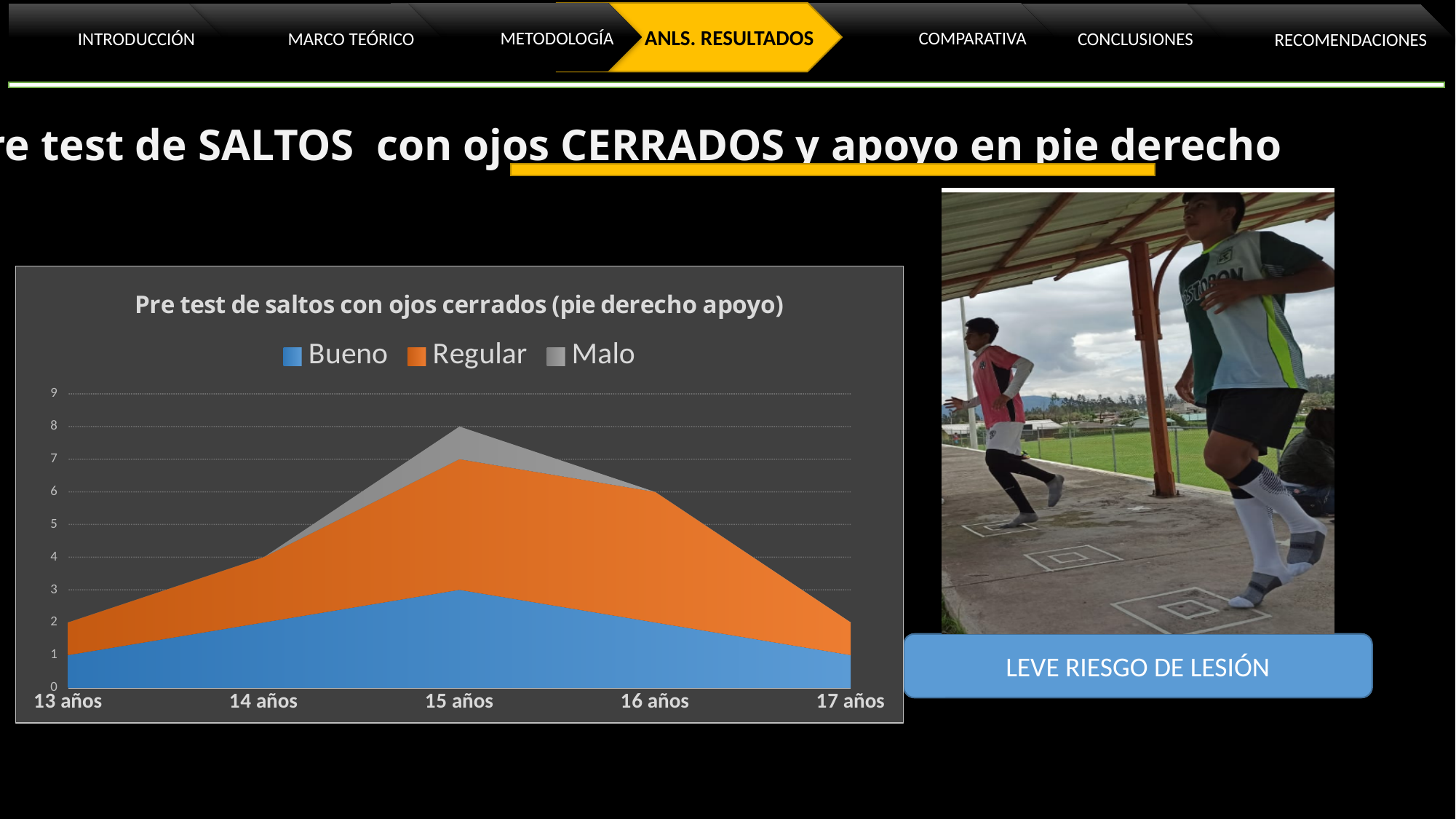
How many series does the chart legend list? 3 What is the title of the chart? Pre test de saltos con ojos cerrados (pie derecho apoyo) Is the top of the stacked area at 17 años greater or less than 3? less Which colour represents the Regular series? orange Is the top of the stacked area at 15 años greater or less than 7? greater How many age categories are shown on the x axis? 5 Which is larger for the Bueno series: the value at 14 años or the value at 17 años? 14 años Is the value for Bueno at 15 años greater or less than 2? greater What kind of chart is shown on the slide? area chart Does the Bueno series rise or fall from 15 años to 17 años? fall At which age category does the Bueno series reach its highest value? 15 años